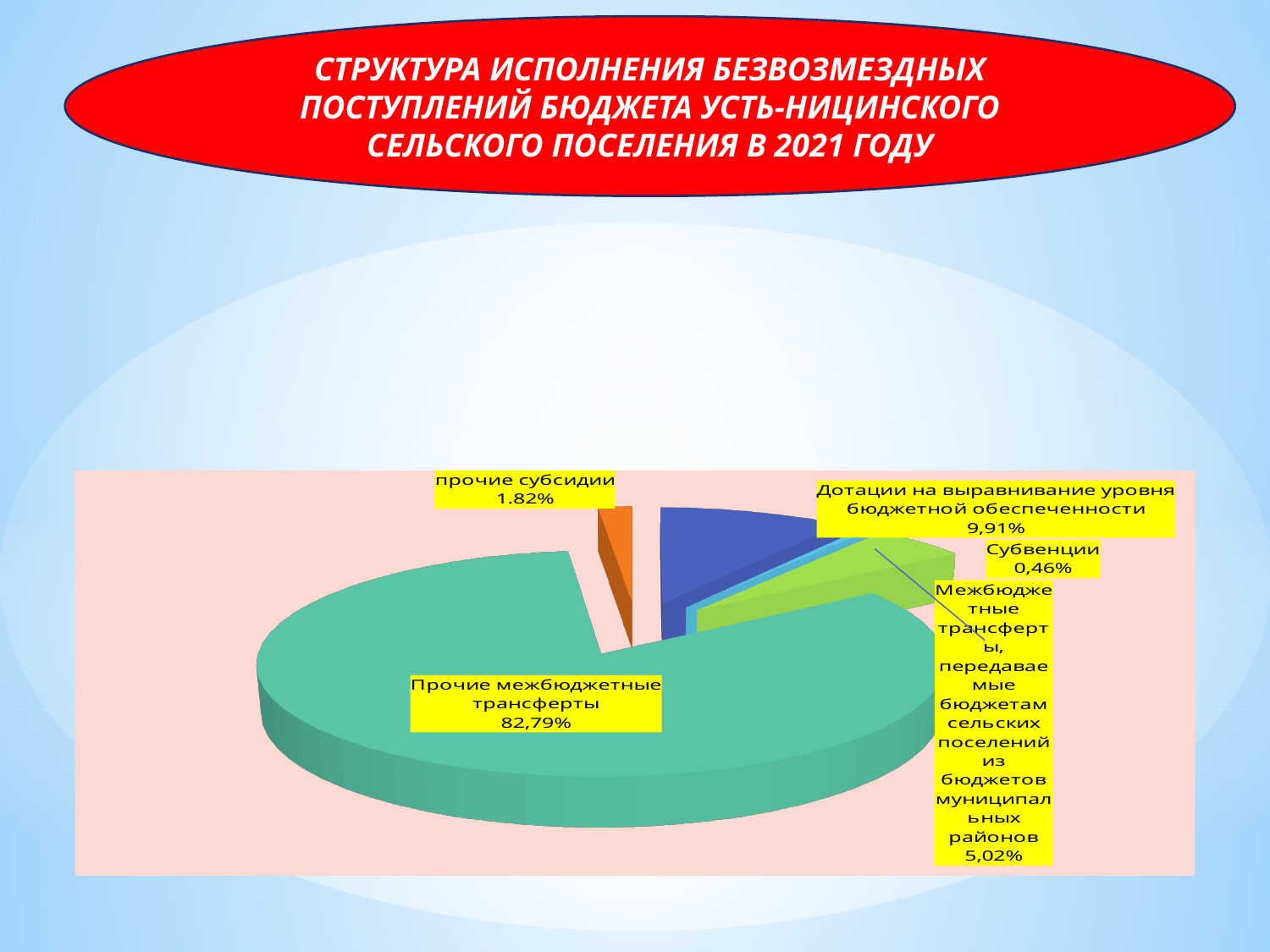
Which is larger: the share for "Дотации на выравнивание уровня бюджетной обеспеченности" or the share for "прочие субсидии"? Дотации на выравнивание уровня бюджетной обеспеченности What kind of chart is shown on the slide? Pie chart What is the value shown for "Субвенции"? 0,46% Which year does the slide title say the structure of gratuitous budget receipts refers to? 2021 What is the value shown for "прочие субсидии"? 1.82% Which category has the largest share of the pie? Прочие межбюджетные трансферты How many slices does the pie chart have? 5 What is the value shown for "Межбюджетные трансферты, передаваемые бюджетам сельских поселений из бюджетов муниципальных районов"? 5,02% What is the value shown for "Дотации на выравнивание уровня бюджетной обеспеченности"? 9,91% Which category has the smallest share of the pie? Субвенции What is the difference in percentage points between "Дотации на выравнивание уровня бюджетной обеспеченности" (9,91%) and "Межбюджетные трансферты, передаваемые бюджетам сельских поселений из бюджетов муниципальных районов" (5,02%)? 4,89 What share of the pie is labelled "Прочие межбюджетные трансферты"? 82,79%